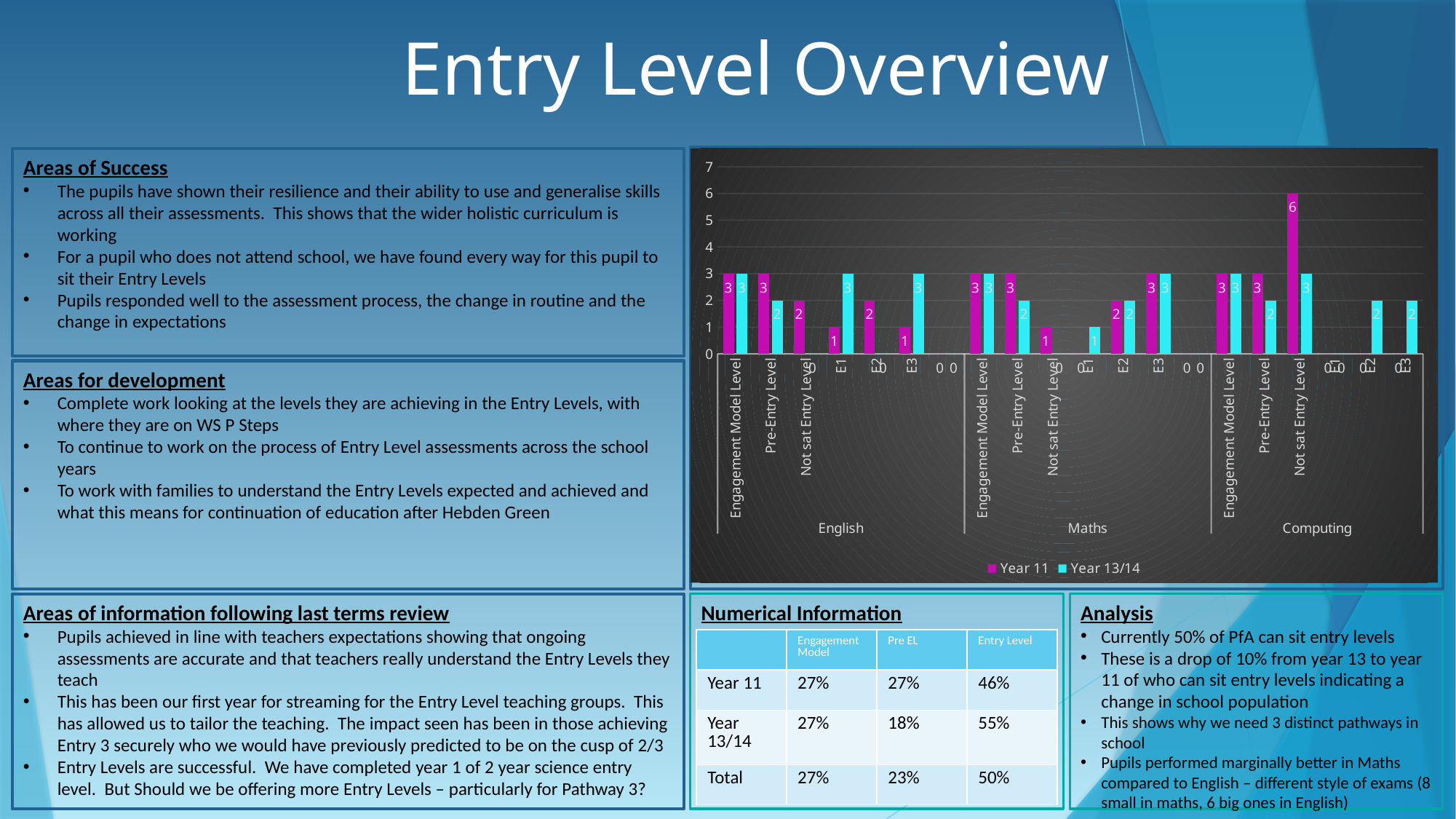
Which bar in the chart has the highest value? Year 11, Not sat Entry Level, Computing How many subject groups are shown along the x axis of the chart? 3 What is the Year 11 value for Pre-Entry Level in Maths? 3 What is the difference between the Year 11 and Year 13/14 values for Not sat Entry Level in Computing? 3 How many series does the chart legend list? 2 What kind of chart is shown on the slide? bar chart What is the Year 13/14 value for E1 in English? 3 What is the Year 13/14 value for E3 in Computing? 2 What are the two series named in the chart legend? Year 11 and Year 13/14 What is the Year 11 value for Not sat Entry Level in Computing? 6 For E1 in English, which series has the larger value, Year 11 or Year 13/14? Year 13/14 What is the Year 11 value for E2 in Maths? 2